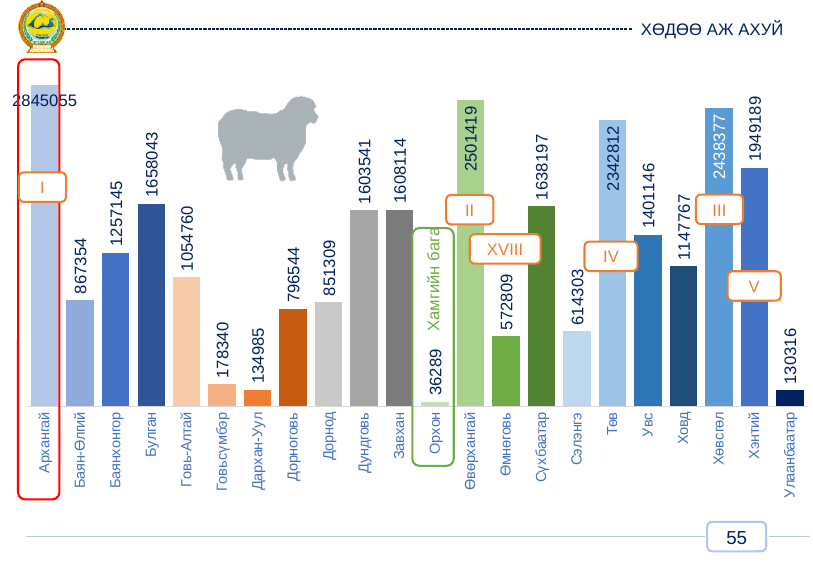
What is the value shown for Архангай? 2845055 What is the difference between the values for Төв and Хэнтий? 393623 What is the value shown for Сүхбаатар? 1638197 What is the value shown for Орхон? 36289 Which category has the lowest value? Орхон What is the value shown for Хөвсгөл? 2438377 What is the difference between the values for Архангай and Өвөрхангай? 343636 Which category is annotated with the label "Хамгийн бага"? Орхон Which is larger, the value for Увс or the value for Ховд? Увс What kind of chart is shown on the slide? Bar chart Which category has the highest value? Архангай How many categories are shown on the chart? 22